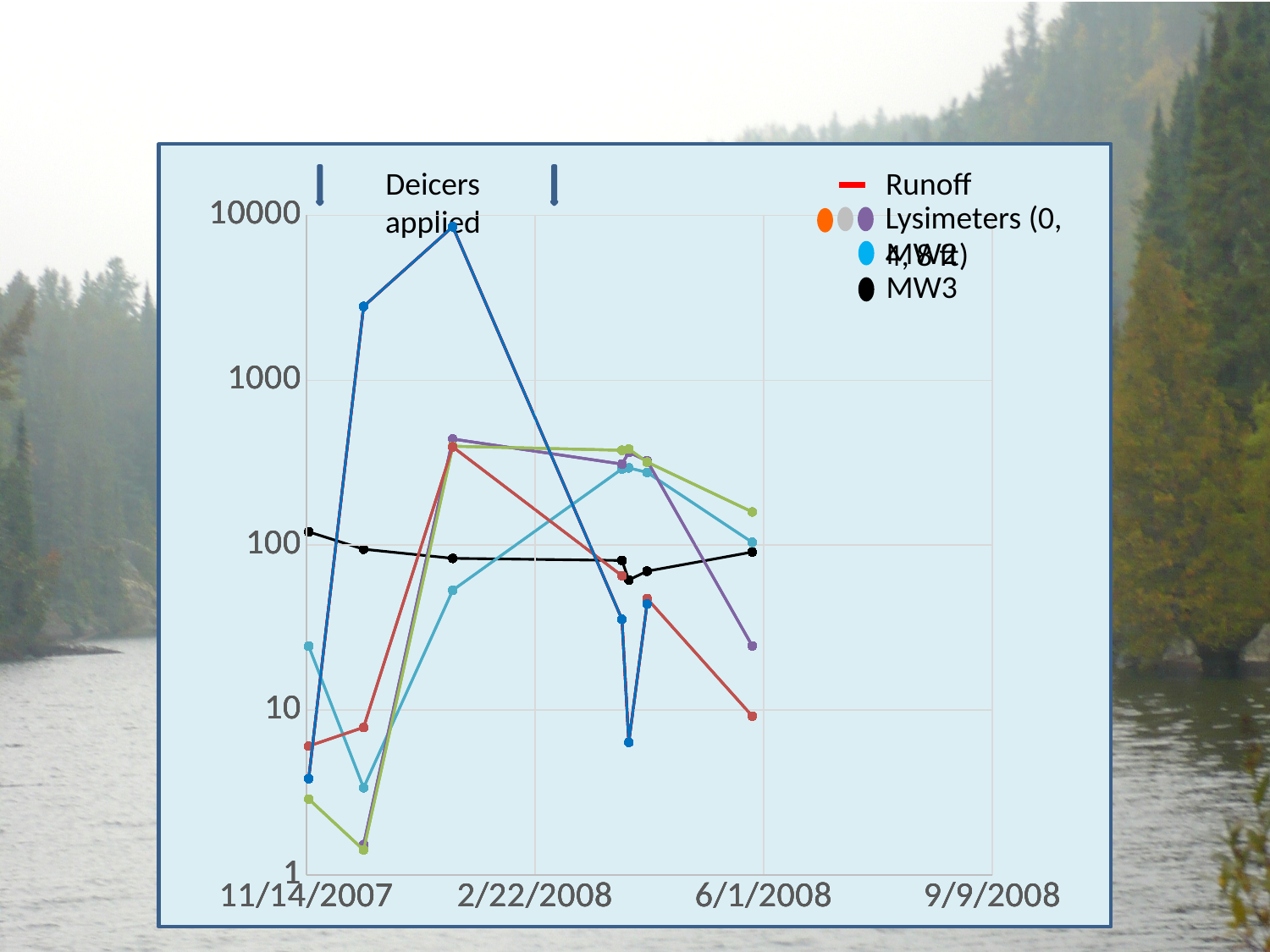
Is the value of the MW3 series at 2/22/2008 greater or less than 100? less Is the first plotted value of the MW3 series (at 11/14/2007) greater or less than 100? greater Which series in the legend is drawn in black? MW3 What is the highest value labelled on the y axis? 10000 What is the first date labelled on the x axis? 11/14/2007 Does the Runoff series rise or fall from its peak to its last point near 6/1/2008? fall What annotation text appears at the top of the chart near the arrows? Deicers applied Is the highest point plotted on the chart greater or less than 1000? greater What kind of chart is shown on the slide? line chart How many date labels are shown on the x axis? 4 Does the MW3 series rise or fall between 11/14/2007 and 2/22/2008? fall